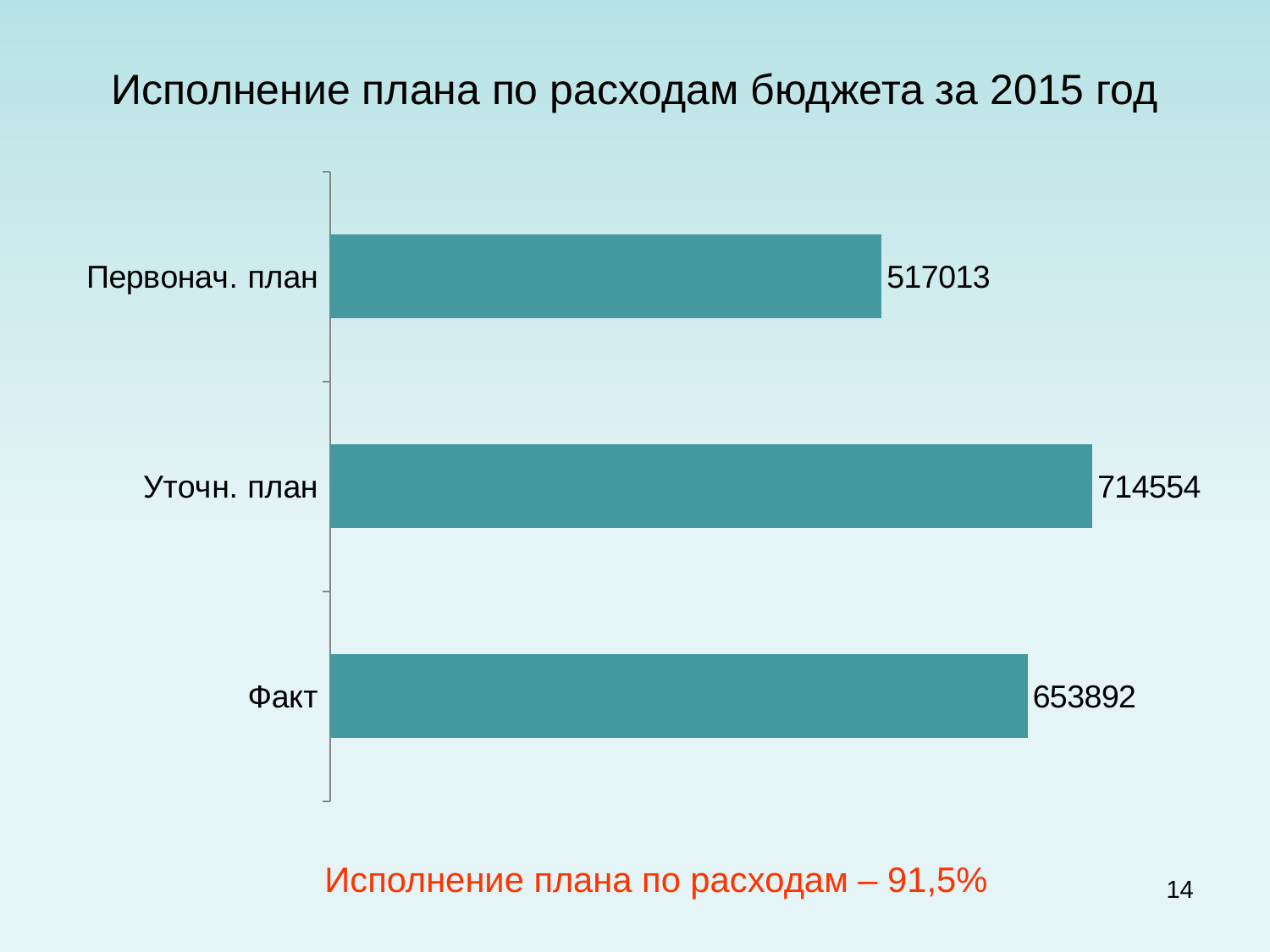
How many categories are shown in the chart? 3 What percentage of plan execution for expenditures is stated below the chart? 91,5% Which category has the highest value? Уточн. план Which is larger, Факт or Первонач. план? Факт What is the difference between Факт and Первонач. план? 136879 What is the value for Первонач. план? 517013 Which category has the lowest value? Первонач. план What is the title of the slide? Исполнение плана по расходам бюджета за 2015 год What is the difference between Уточн. план and Факт? 60662 What kind of chart is shown on the slide? Bar chart What is the value for Факт? 653892 What is the value for Уточн. план? 714554